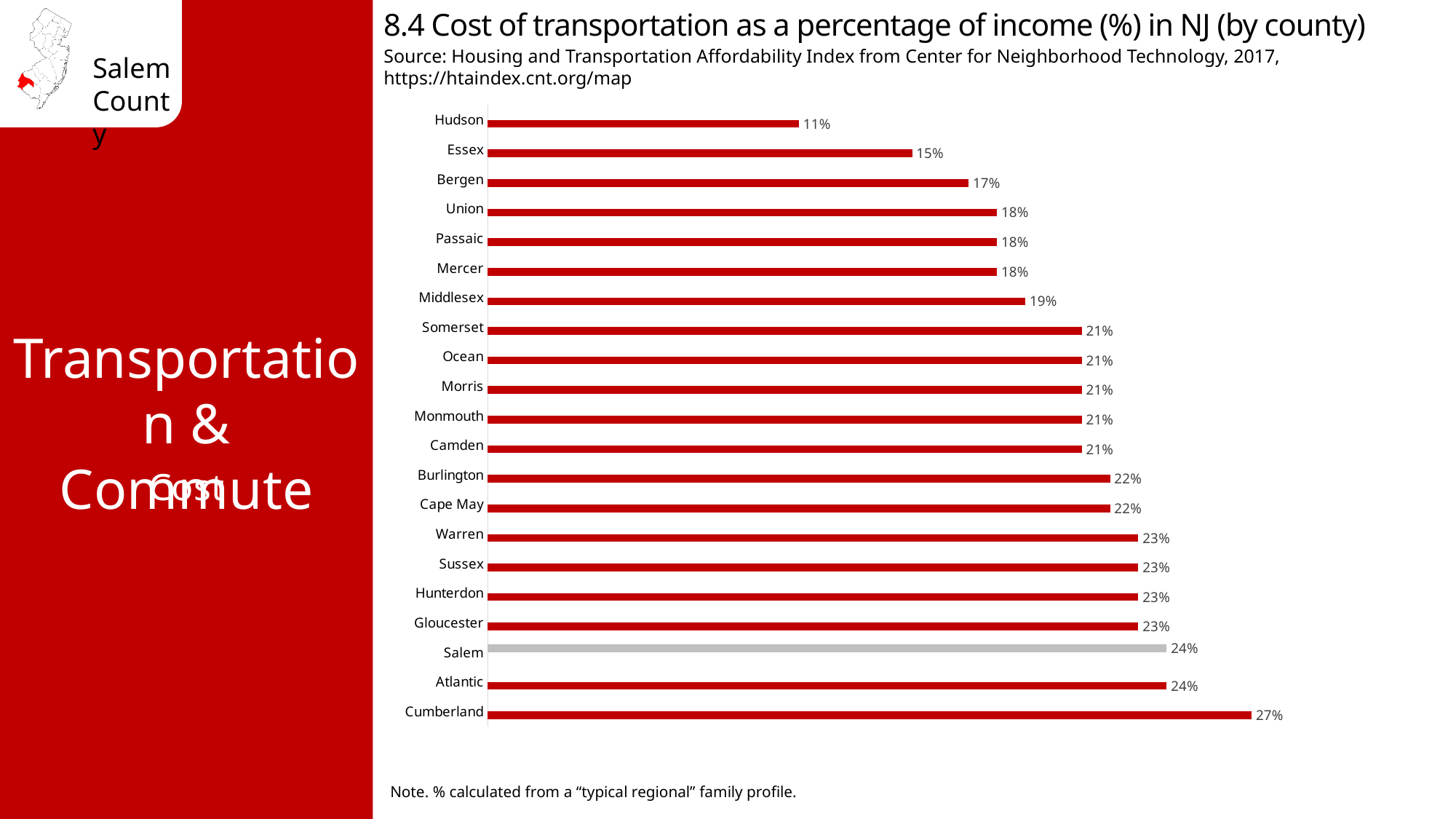
How many counties are shown in the chart? 21 Which county has the highest cost of transportation as a percentage of income? Cumberland What is the difference between the values for Cumberland and Hudson? 16% What is the value shown for Middlesex county? 19% Which county's bar is coloured grey instead of red? Salem Which has a higher value, Bergen or Gloucester? Gloucester Which has a higher value, Atlantic or Union? Atlantic Which county has the lowest cost of transportation as a percentage of income? Hudson What is the cost of transportation as a percentage of income for Salem county? 24% What is the cost of transportation as a percentage of income for Hudson county? 11% What kind of chart is shown on the slide? Bar chart What is the difference between the values for Salem and Essex? 9%